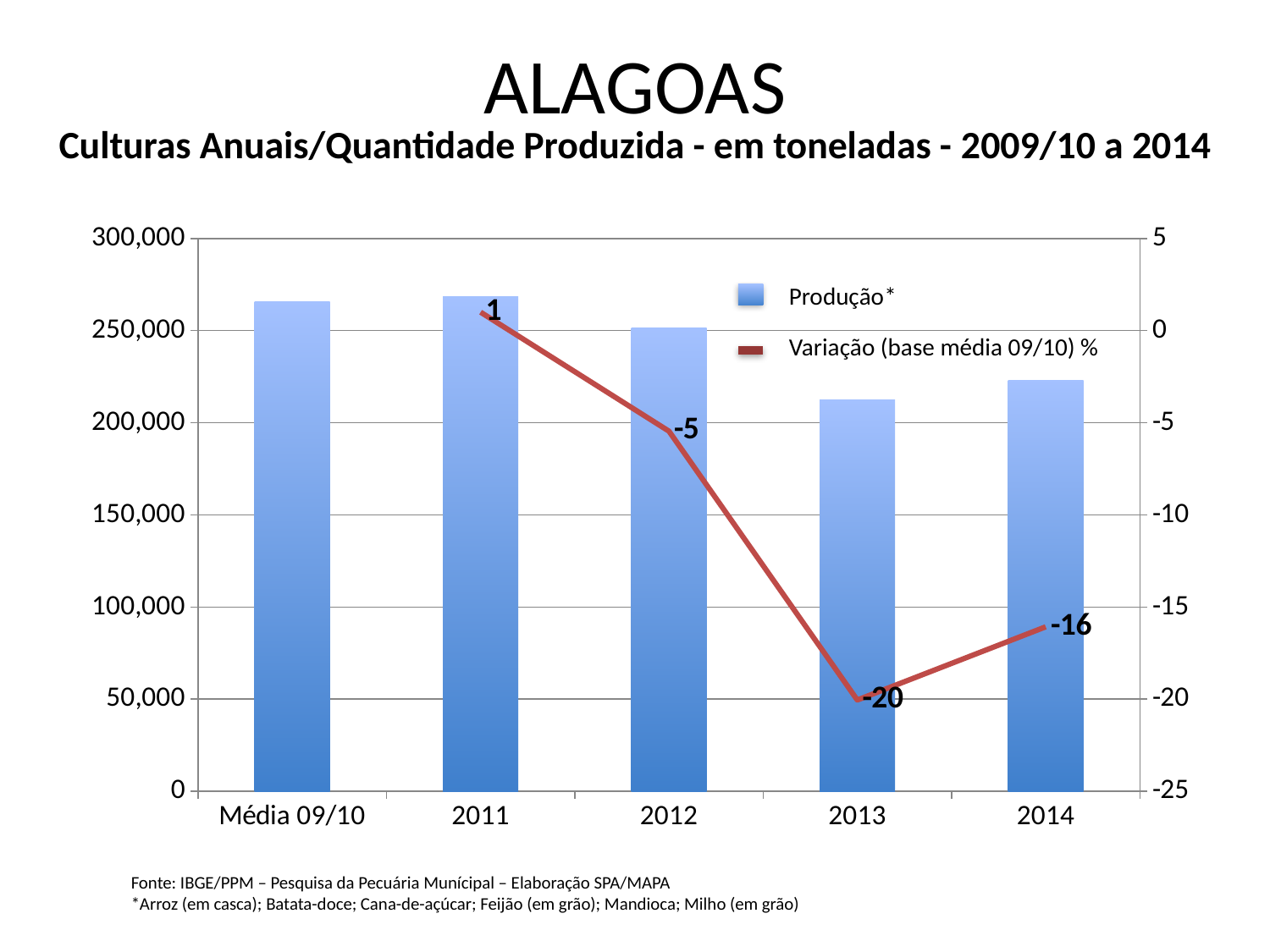
Which year has the highest Variação (base média 09/10) % value? 2011 What is the value of Variação (base média 09/10) % for 2014? -16 Which has a larger Produção value, 2012 or 2013? 2012 Does the Variação line rise or fall from 2011 to 2013? fall Is the Produção value for 2011 greater or less than 250,000? greater What is the value of Variação (base média 09/10) % for 2011? 1 How many categories are shown on the x axis? 5 How many series does the legend list? 2 Is the Produção value for 2013 greater or less than 250,000? less What is the difference between the Variação values for 2014 and 2013? 4 Which year has the lowest Variação (base média 09/10) % value? 2013 What is the value of Variação (base média 09/10) % for 2013? -20